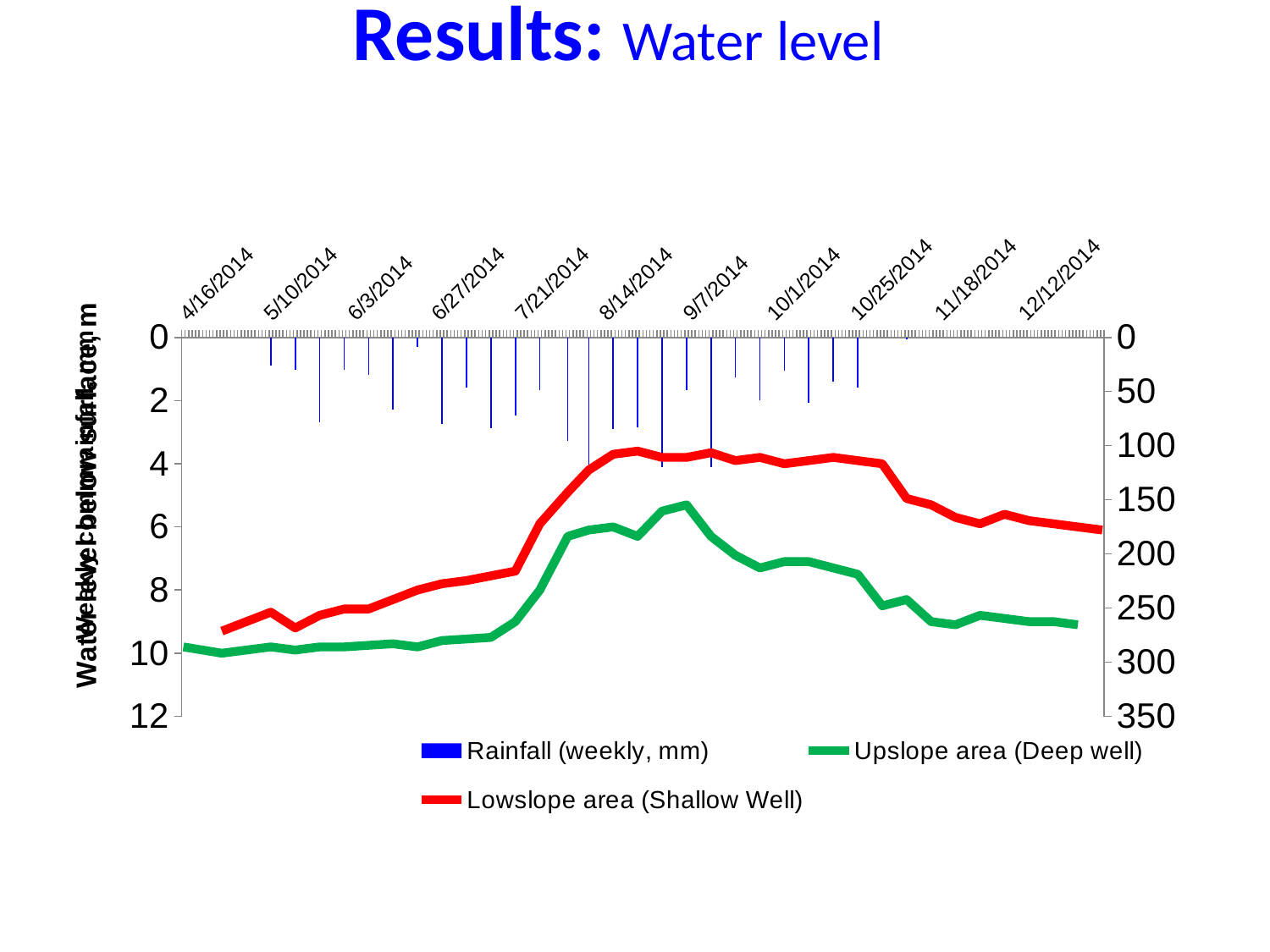
Is the plotted value for Lowslope area (Shallow Well) at 8/14/2014 greater or less than 6? less Do the plotted values for Lowslope area (Shallow Well) rise or fall between 10/25/2014 and 12/12/2014? rise What is the highest tick value shown on the right-hand axis? 350 What colour is the Upslope area (Deep well) series in the legend? Green Is the plotted value for Lowslope area (Shallow Well) at 7/21/2014 greater or less than 6? greater Do the plotted values for Upslope area (Deep well) rise or fall between 4/16/2014 and 9/7/2014? fall Is the plotted value for Upslope area (Deep well) at 4/16/2014 greater or less than 8? greater What kind of chart is this? Combination chart with bars and lines How many date labels are shown along the x axis? 11 How many series does the legend list? 3 At 6/3/2014, which line has the larger plotted value on the left axis: Upslope area (Deep well) or Lowslope area (Shallow Well)? Upslope area (Deep well)